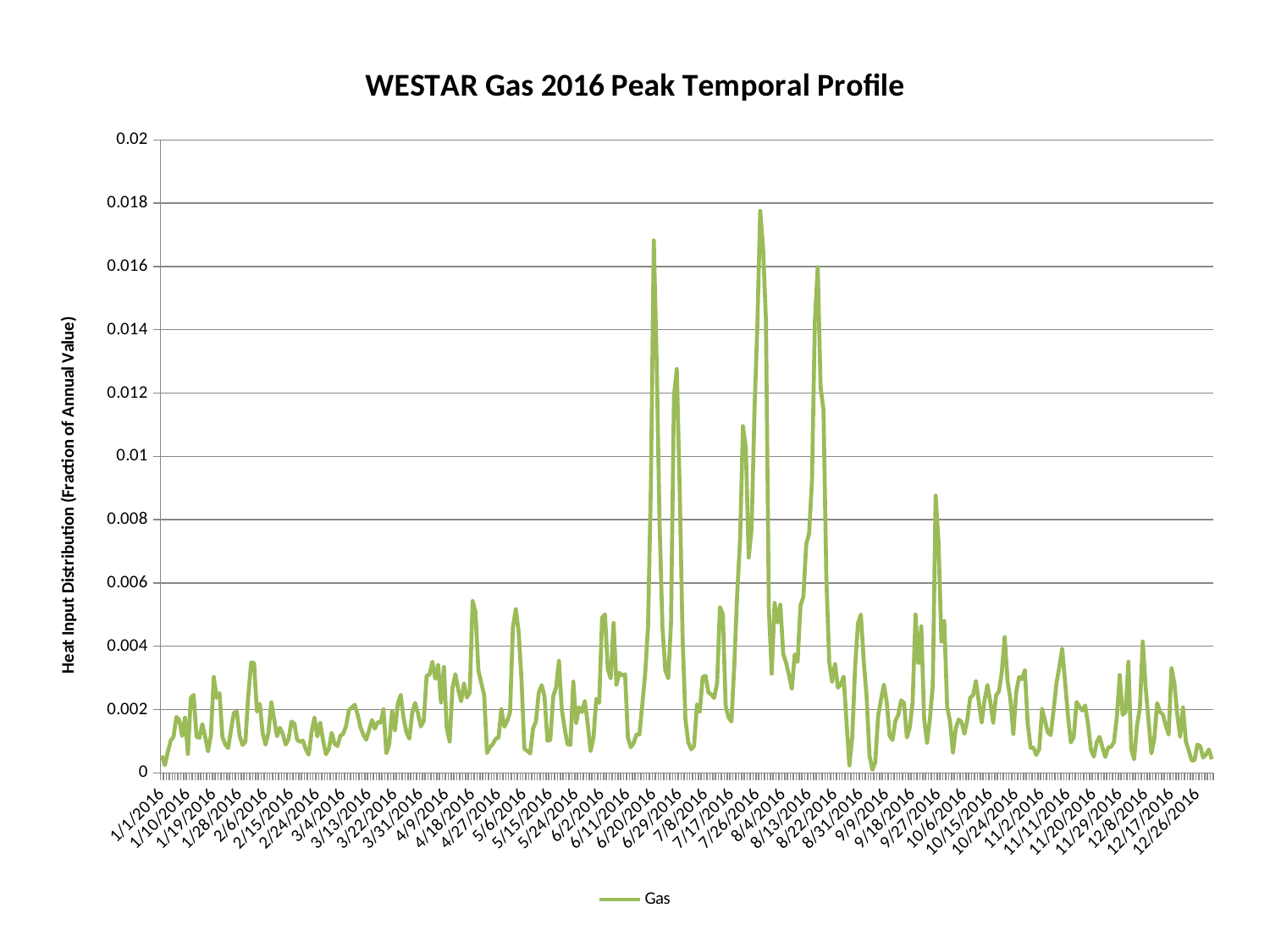
Is the peak of the Gas line near 9/27/2016 greater or less than 0.006? greater Which is higher: the peak of the Gas line near 6/29/2016 or the peak near 9/27/2016? the peak near 6/29/2016 What is the title of the chart? WESTAR Gas 2016 Peak Temporal Profile What is the maximum value shown on the y axis? 0.02 Is the peak of the Gas line near 6/20/2016 greater or less than 0.014? greater What kind of chart is shown on the slide? line chart Does the highest peak of the Gas line occur in the first half or the second half of 2016? second half Is the value for Gas on 1/1/2016 greater or less than 0.002? less What is the label of the series shown in the legend? Gas How many series does the legend list? 1 Do the values of the Gas line generally rise or fall from 8/22/2016 to 12/26/2016? fall